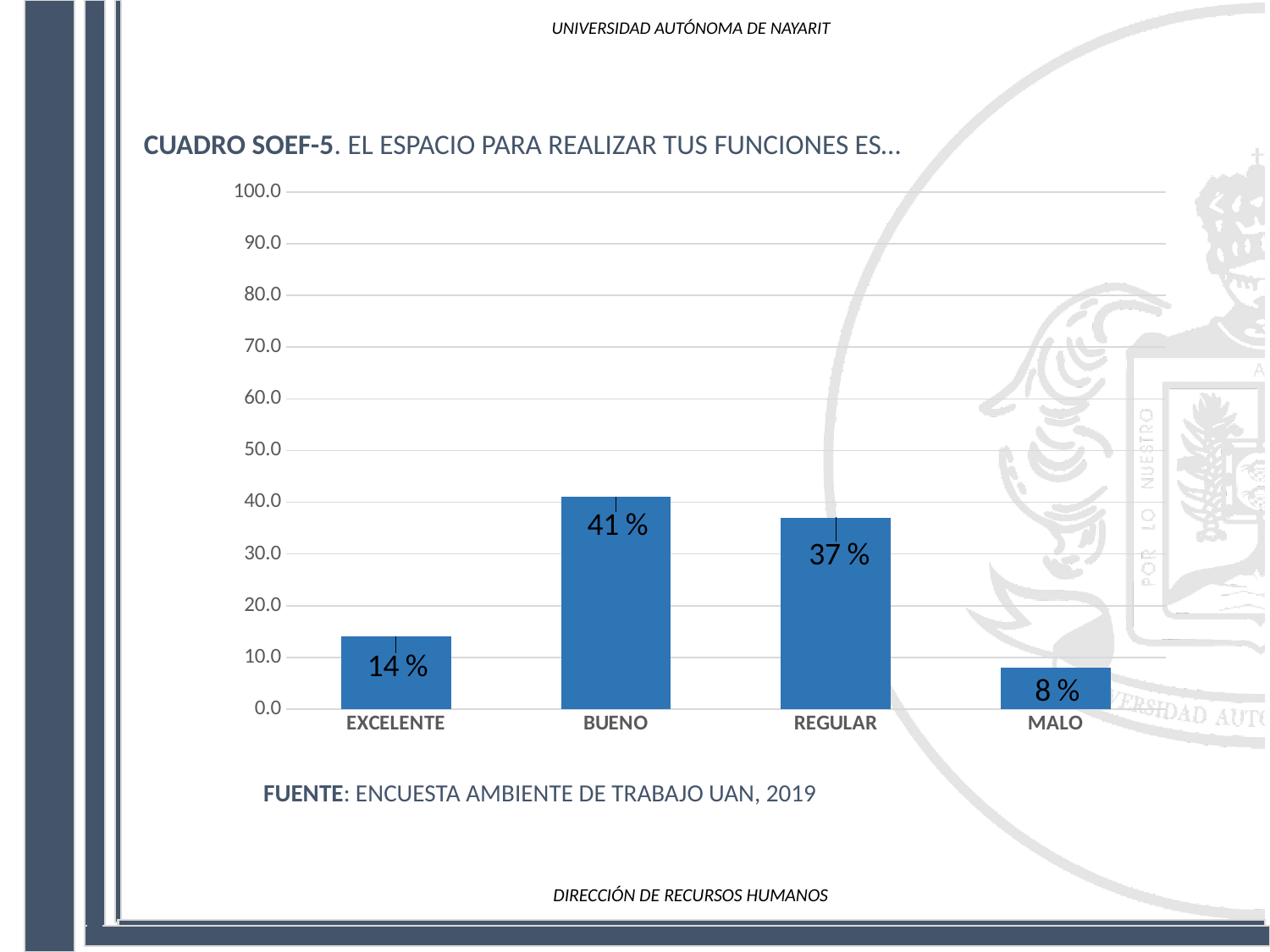
Which category has the lowest value? MALO Which is larger, the value for EXCELENTE or the value for MALO? EXCELENTE What is the value for BUENO? 41 % Which category has the highest value? BUENO Is the value for REGULAR greater or less than 30.0? greater What is the value for REGULAR? 37 % What is the value for MALO? 8 % How many categories are shown on the x axis? 4 What is the difference between the values for BUENO and REGULAR? 4 % What is the value for EXCELENTE? 14 % What is the source cited below the chart? ENCUESTA AMBIENTE DE TRABAJO UAN, 2019 What kind of chart is shown on the slide? bar chart